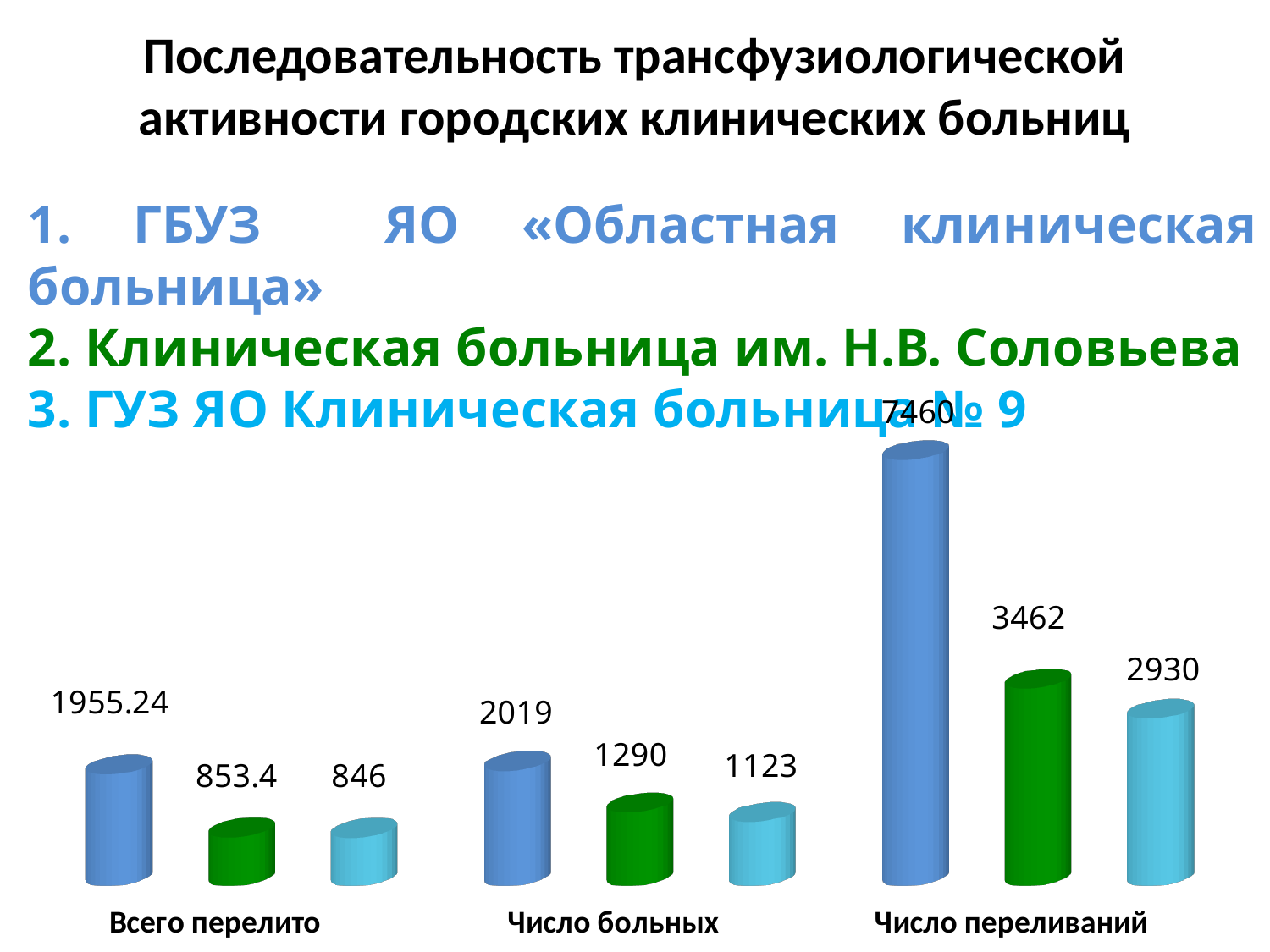
Which category has the highest blue bar? Число переливаний What is the difference between the green and light blue bars for "Число больных"? 167 What is the value of the green bar for "Всего перелито"? 853.4 How many categories are shown on the x axis? 3 Which bar has the lowest value in the whole chart? The light blue bar for Всего перелито (846) What type of chart is shown on the slide? Bar chart What is the difference between the blue and green bars for "Число переливаний"? 3998 Which is larger for "Число переливаний": the green bar or the light blue bar? The green bar (3462) What is the value of the blue bar for "Число переливаний"? 7460 What is the value of the blue bar for "Всего перелито"? 1955.24 What is the value of the light blue bar for "Число больных"? 1123 How many bars are shown in each category? 3